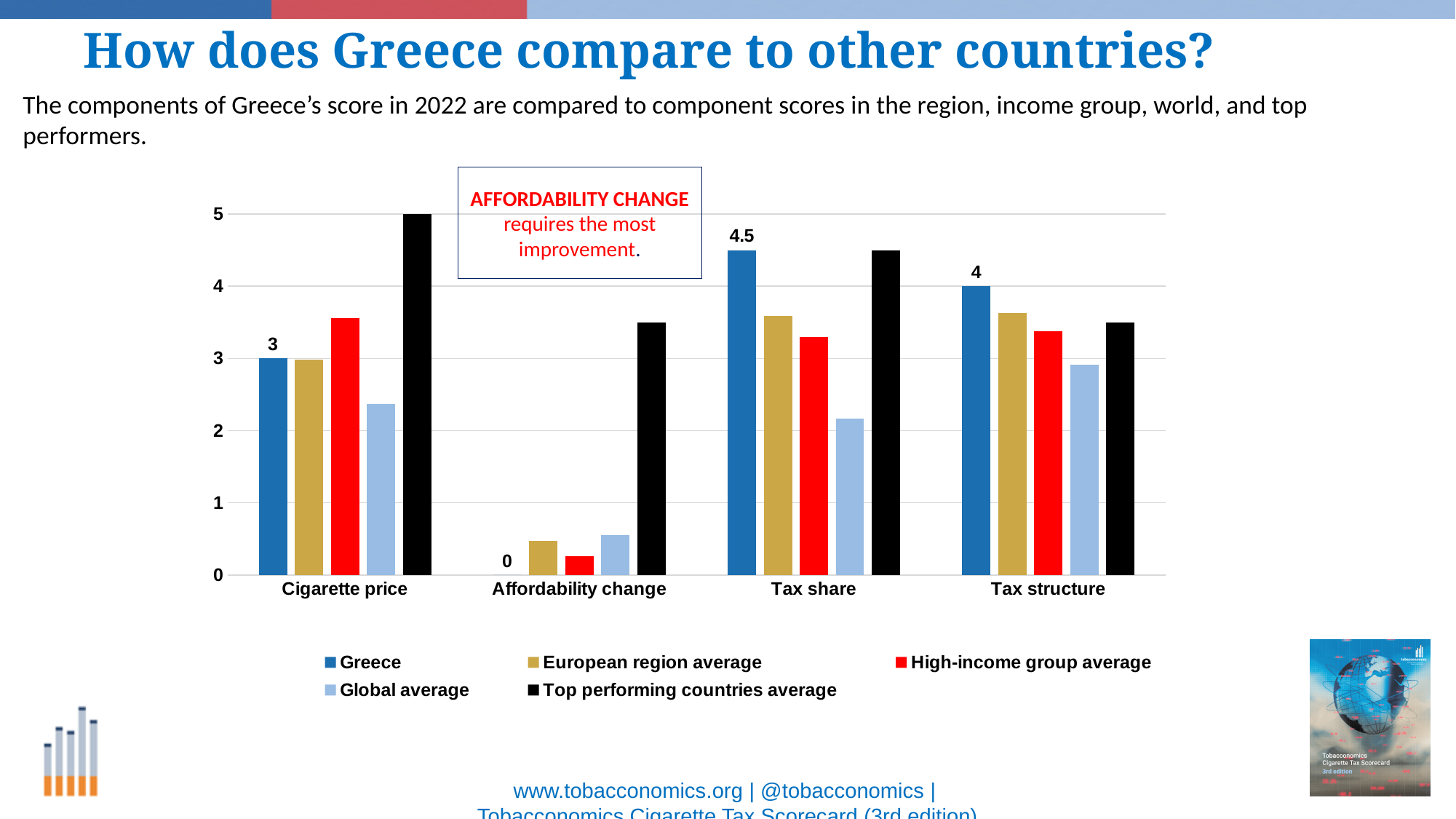
What is Greece's score for Affordability change? 0 Which component has the lowest score for Greece? Affordability change What is Greece's score for Tax share? 4.5 Is the Global average for Tax share greater or less than 3? less Which component has the highest score for Greece? Tax share How many series does the legend list? 5 What is Greece's score for Tax structure? 4 For Tax share, which is larger: Greece or the Global average? Greece What is Greece's score for Cigarette price? 3 How many components are shown on the x axis? 4 What kind of chart is shown on the slide? Bar chart What is the difference between Greece's Tax share score and its Cigarette price score? 1.5